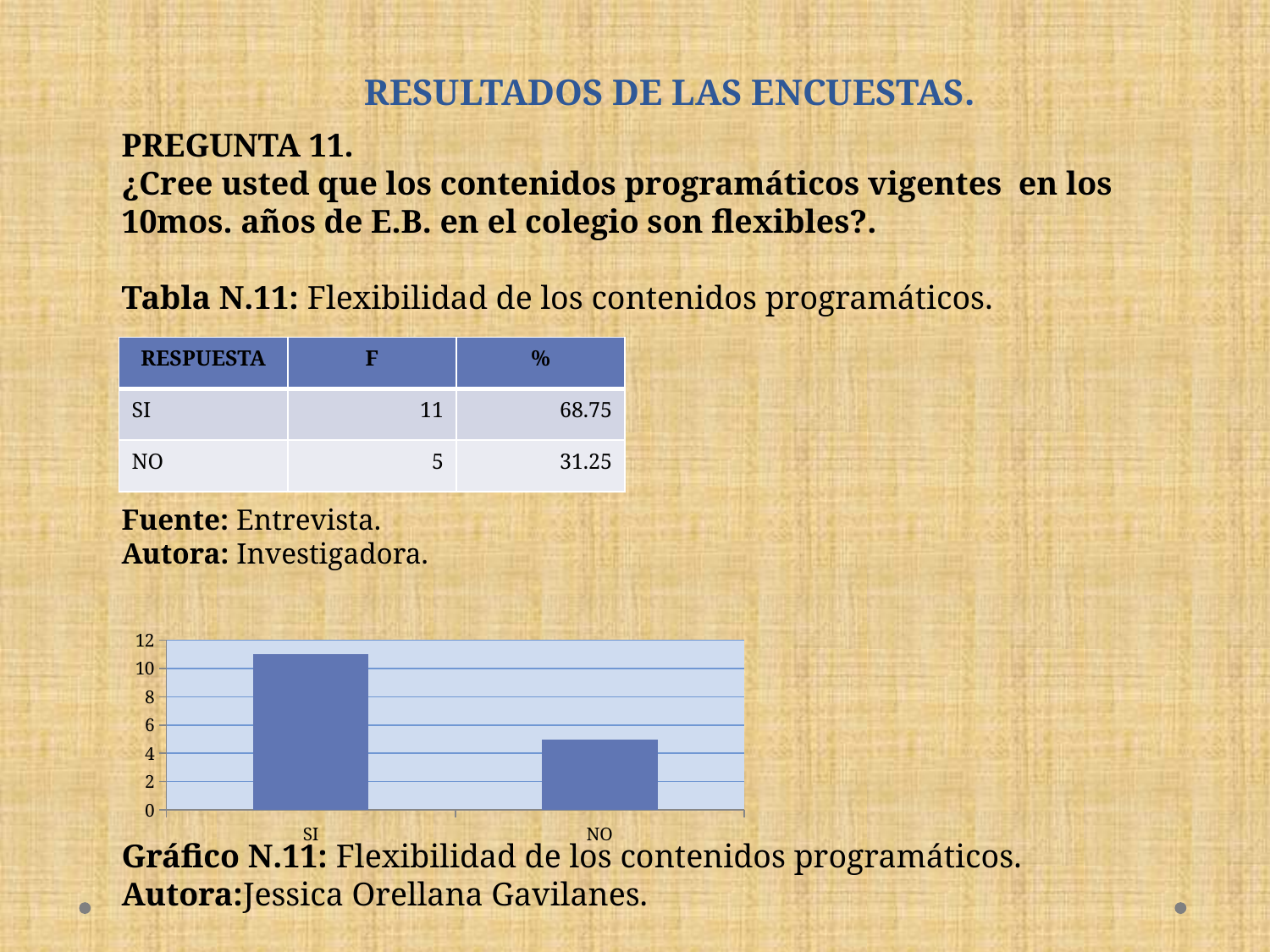
Is the bar for NO greater or less than 6? less Is the bar for SI greater or less than 10? greater Which is larger, the bar for SI or the bar for NO? SI What is the value plotted for NO, as given in the table on the slide? 5 Which category has the highest bar in the chart? SI How many categories are plotted in the chart? 2 Is the bar for SI greater or less than 12? less What is the value plotted for SI, as given in the table on the slide? 11 Which category has the lowest bar in the chart? NO What is the highest value shown on the chart's vertical axis? 12 What kind of chart is shown on the slide? bar chart